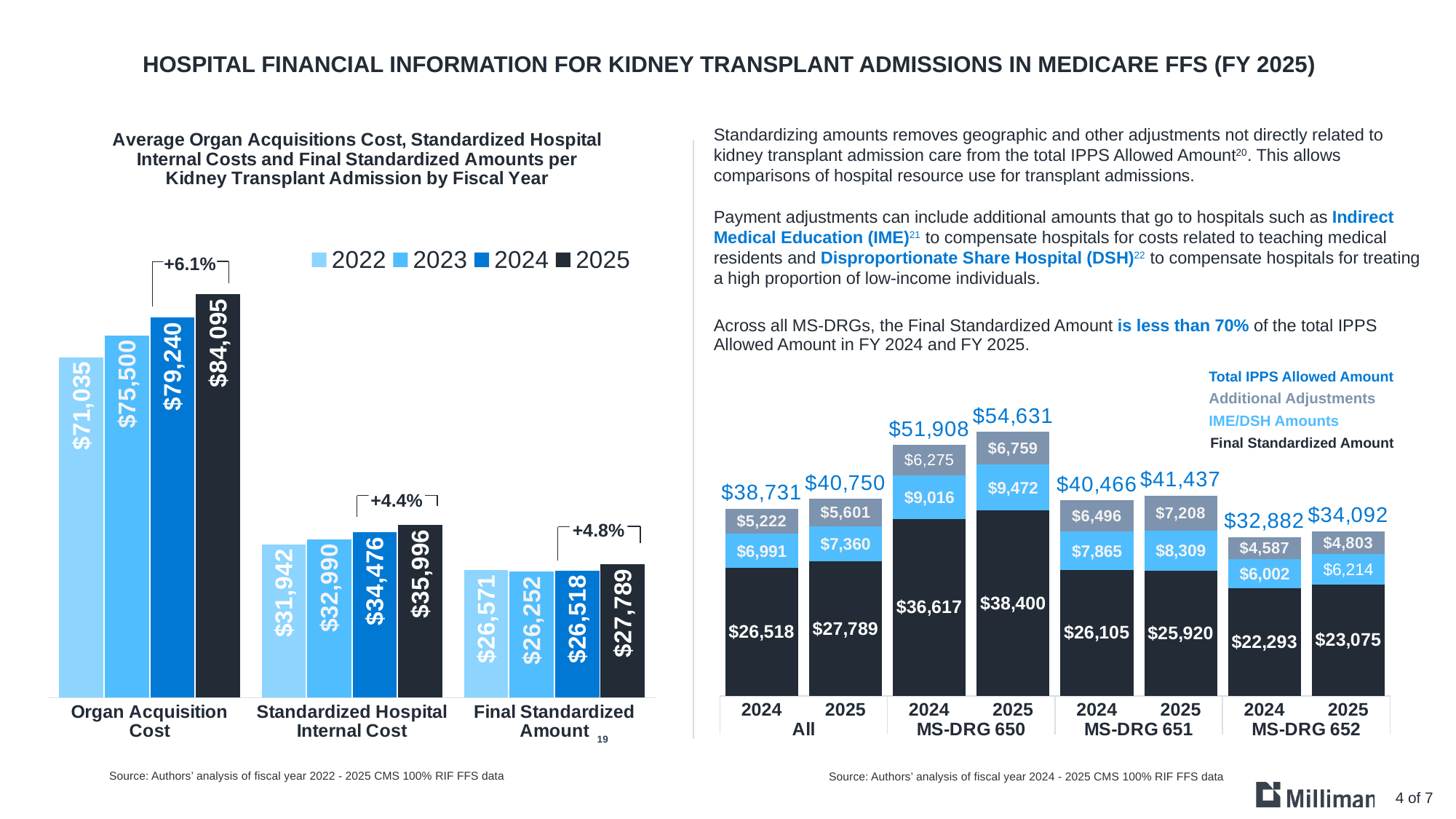
In the left chart (Average Organ Acquisitions Cost, Standardized Hospital Internal Costs and Final Standardized Amounts), what is the Organ Acquisition Cost for 2025? $84,095 In the left chart, which category has the lowest values across all years? Final Standardized Amount In the left chart, what is the Standardized Hospital Internal Cost for 2023? $32,990 In the left chart, what percentage increase is shown above the Standardized Hospital Internal Cost bars? +4.4% In the right chart, what is the difference between the Total IPPS Allowed Amount for MS-DRG 650 in 2025 and in 2024? $2,723 In the right chart, which bar has the highest Total IPPS Allowed Amount? MS-DRG 650 2025 In the left chart, what is the difference between the Organ Acquisition Cost in 2025 and in 2022? $13,060 In the right chart, what is the Total IPPS Allowed Amount for MS-DRG 652 in 2024? $32,882 In the left chart, how many series does the legend list? 4 In the right chart, what kind of chart is shown? stacked bar chart In the left chart, do the Organ Acquisition Cost values rise or fall from 2022 to 2025? rise In the right chart (Total IPPS Allowed Amount), what is the Final Standardized Amount for MS-DRG 650 in 2025? $38,400